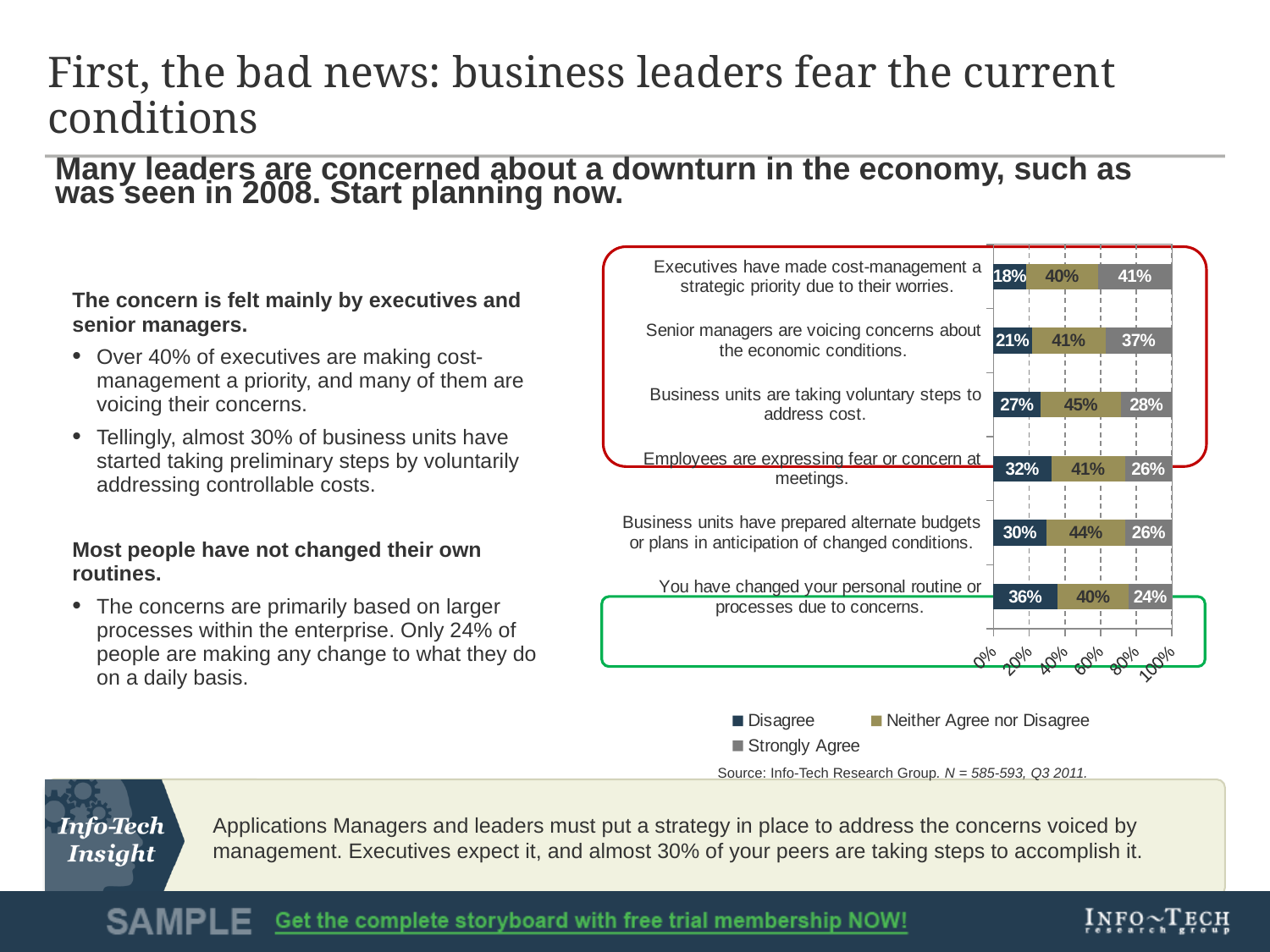
What type of chart is shown on the slide? Stacked bar chart Which is larger: the 'Disagree' value for 'Employees are expressing fear or concern at meetings' or the 'Disagree' value for 'Business units have prepared alternate budgets or plans in anticipation of changed conditions'? Employees are expressing fear or concern at meetings What is the total of the stacked bar for 'Senior managers are voicing concerns about the economic conditions'? 99% Which statement has the lowest 'Disagree' percentage? Executives have made cost-management a strategic priority due to their worries. What percentage of respondents disagree that they have changed their personal routine or processes due to concerns? 36% What is the 'Neither Agree nor Disagree' value for 'Business units are taking voluntary steps to address cost'? 45% What is the difference between the 'Strongly Agree' percentages for 'Senior managers are voicing concerns about the economic conditions' and 'You have changed your personal routine or processes due to concerns'? 13% Which statement has the highest 'Strongly Agree' percentage? Executives have made cost-management a strategic priority due to their worries. What is the source cited below the chart? Info-Tech Research Group. N = 585-593, Q3 2011. What percentage of respondents strongly agree that executives have made cost-management a strategic priority due to their worries? 41% How many statements (categories) are shown in the chart? 6 How many series does the chart legend list? 3